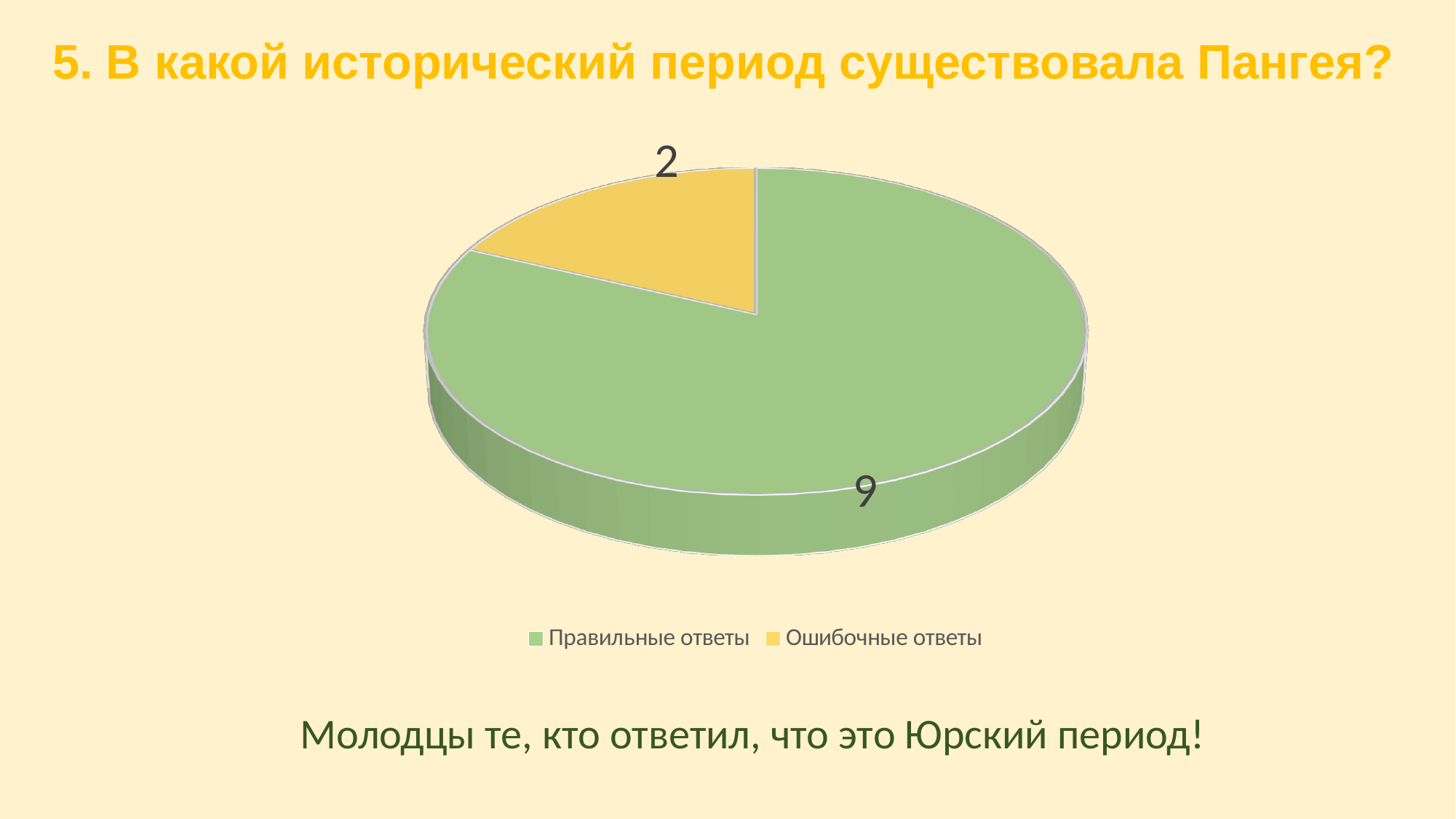
How many entries does the legend list? 2 What colour is the slice for Правильные ответы? green What is the total of all slices in the pie chart? 11 How many slices does the pie chart have? 2 Which category has the smallest slice? Ошибочные ответы What kind of chart is shown on the slide? pie chart What is the value for Правильные ответы? 9 What is the difference between Правильные ответы and Ошибочные ответы? 7 Which is larger, Правильные ответы or Ошибочные ответы? Правильные ответы What colour is the slice for Ошибочные ответы? yellow Which category has the largest slice? Правильные ответы What is the value for Ошибочные ответы? 2